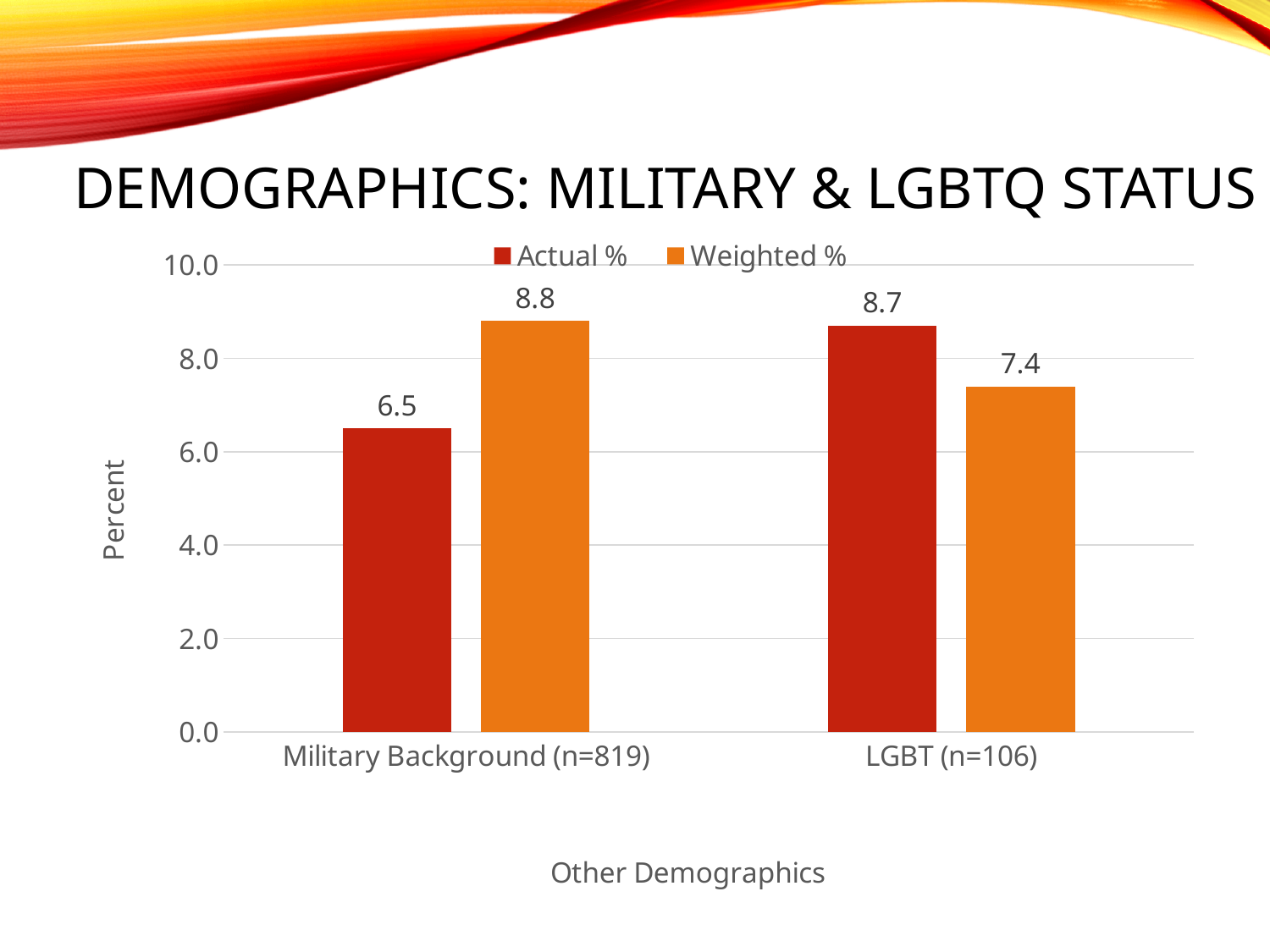
Which is larger for LGBT (n=106): the Actual % or the Weighted % value? Actual % Which category has the highest Weighted % value? Military Background (n=819) What is the difference between the Actual % and Weighted % values for LGBT (n=106)? 1.3 What is the Actual % value for LGBT (n=106)? 8.7 What kind of chart is shown on the slide? Bar chart What is the Weighted % value for Military Background (n=819)? 8.8 What is the Weighted % value for LGBT (n=106)? 7.4 What is the Actual % value for Military Background (n=819)? 6.5 How many categories are shown on the x axis? 2 Which category has the lowest Actual % value? Military Background (n=819) How many series does the legend list? 2 What is the difference between the Weighted % and Actual % values for Military Background (n=819)? 2.3